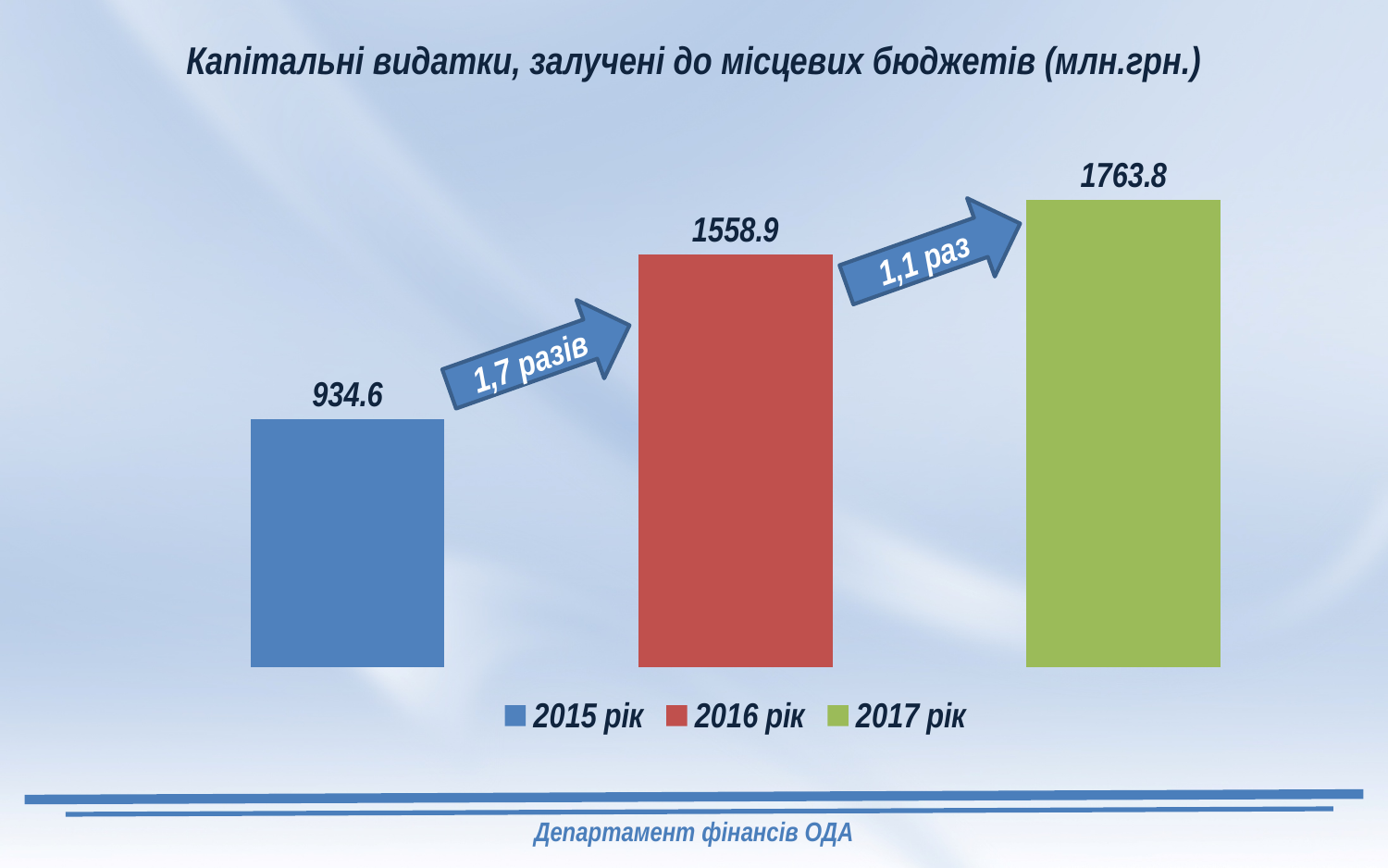
What is the difference between the values for 2017 рік and 2016 рік? 204.9 How many series does the legend list? 3 What kind of chart is shown on the slide? bar chart What is the difference between the values for 2016 рік and 2015 рік? 624.3 Which year has the lowest value? 2015 рік What is the value for 2017 рік? 1763.8 Which is larger, the value for 2016 рік or the value for 2017 рік? 2017 рік What is the value for 2015 рік? 934.6 Which year has the highest value? 2017 рік Do the values rise or fall from 2015 рік to 2017 рік? rise How many bars are shown in the chart? 3 What is the value for 2016 рік? 1558.9